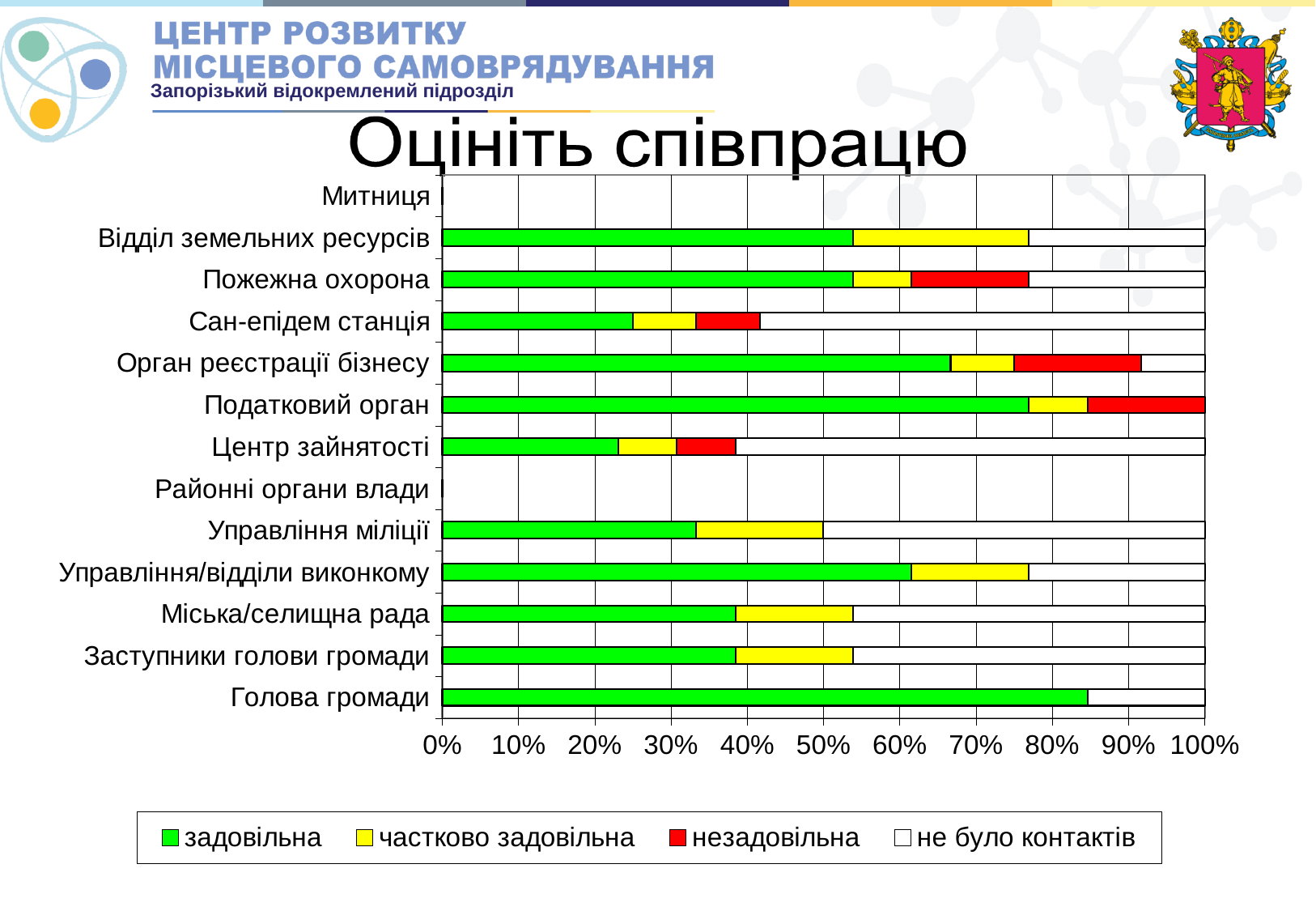
Is the 'задовільна' value for Сан-епідем станція greater or less than 30%? less What kind of chart is shown on the slide? Stacked horizontal bar chart Is the 'задовільна' value for Центр зайнятості greater or less than 30%? less How many series does the legend list? 4 What is the title of the chart? Оцініть співпрацю Which has a larger 'задовільна' segment: Орган реєстрації бізнесу or Управління міліції? Орган реєстрації бізнесу Which has a larger 'задовільна' segment: Голова громади or Міська/селищна рада? Голова громади Is the 'задовільна' value for Податковий орган greater or less than 70%? greater Which category has the largest 'задовільна' (green) segment? Голова громади Which colour represents the series 'незадовільна' in the chart? Red How many categories are listed on the vertical axis of the chart? 13